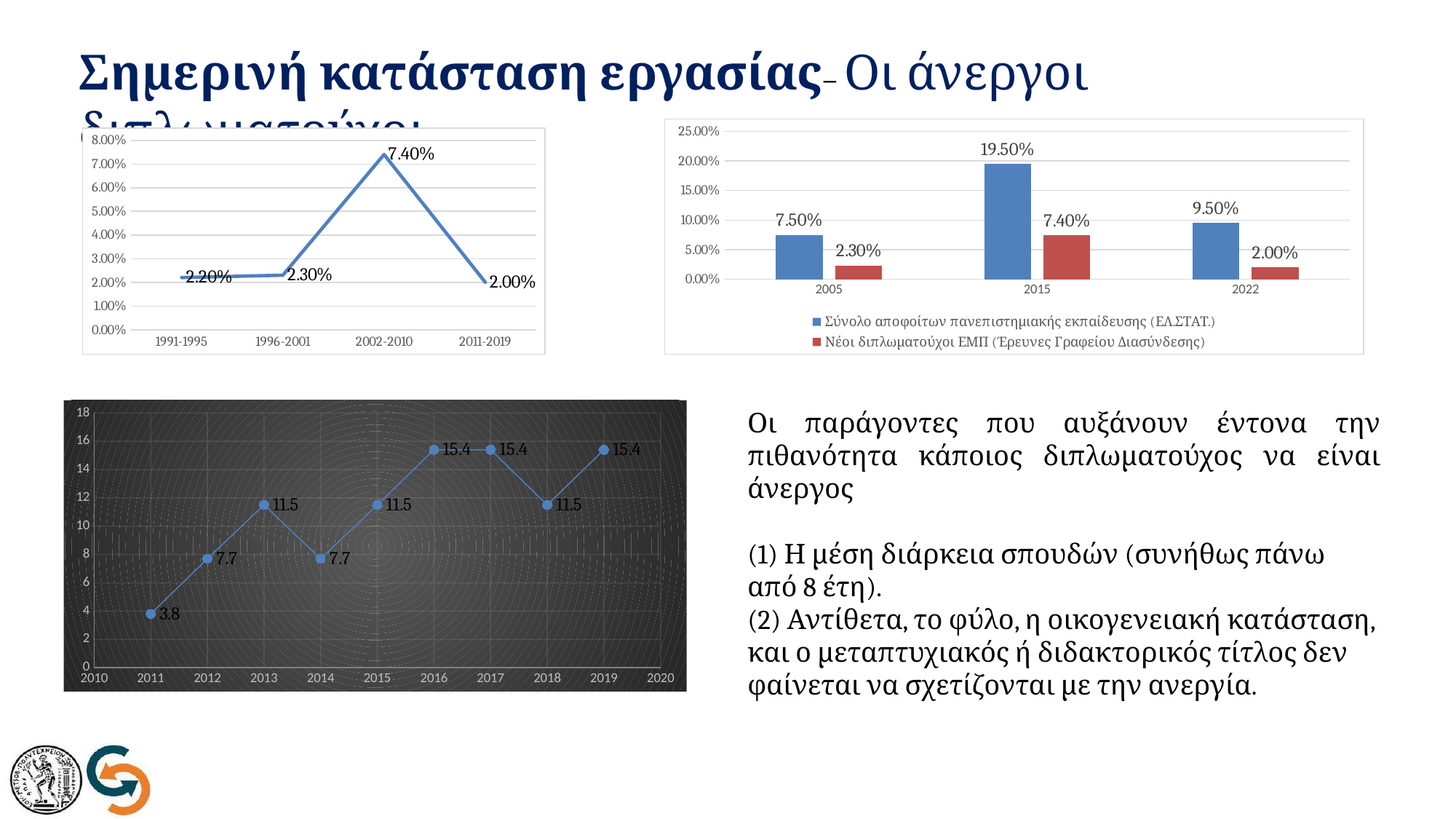
In the top-left line chart, which period has the lowest value? 2011-2019 In the top-right bar chart, what is the value for 2015 for the series 'Σύνολο αποφοίτων πανεπιστημιακής εκπαίδευσης (ΕΛ.ΣΤΑΤ.)'? 19.50% What kind of chart is the top-right chart? Bar chart In the top-left line chart, what is the value for 2002-2010? 7.40% In the bottom-left line chart, what is the difference between the values for 2016 and 2018? 3.9 In the top-right bar chart, what is the difference between the two series in 2015? 12.10% In the top-right bar chart, how many series does the legend list? 2 In the top-right bar chart, which year has the highest value for 'Σύνολο αποφοίτων πανεπιστημιακής εκπαίδευσης (ΕΛ.ΣΤΑΤ.)'? 2015 In the top-left line chart, how many periods are plotted on the x axis? 4 In the bottom-left line chart, what is the value for 2011? 3.8 In the top-right bar chart, what is the value for 2022 for the series 'Νέοι διπλωματούχοι ΕΜΠ (Έρευνες Γραφείου Διασύνδεσης)'? 2.00% In the bottom-left line chart, which is larger, the value for 2014 or the value for 2015? 2015